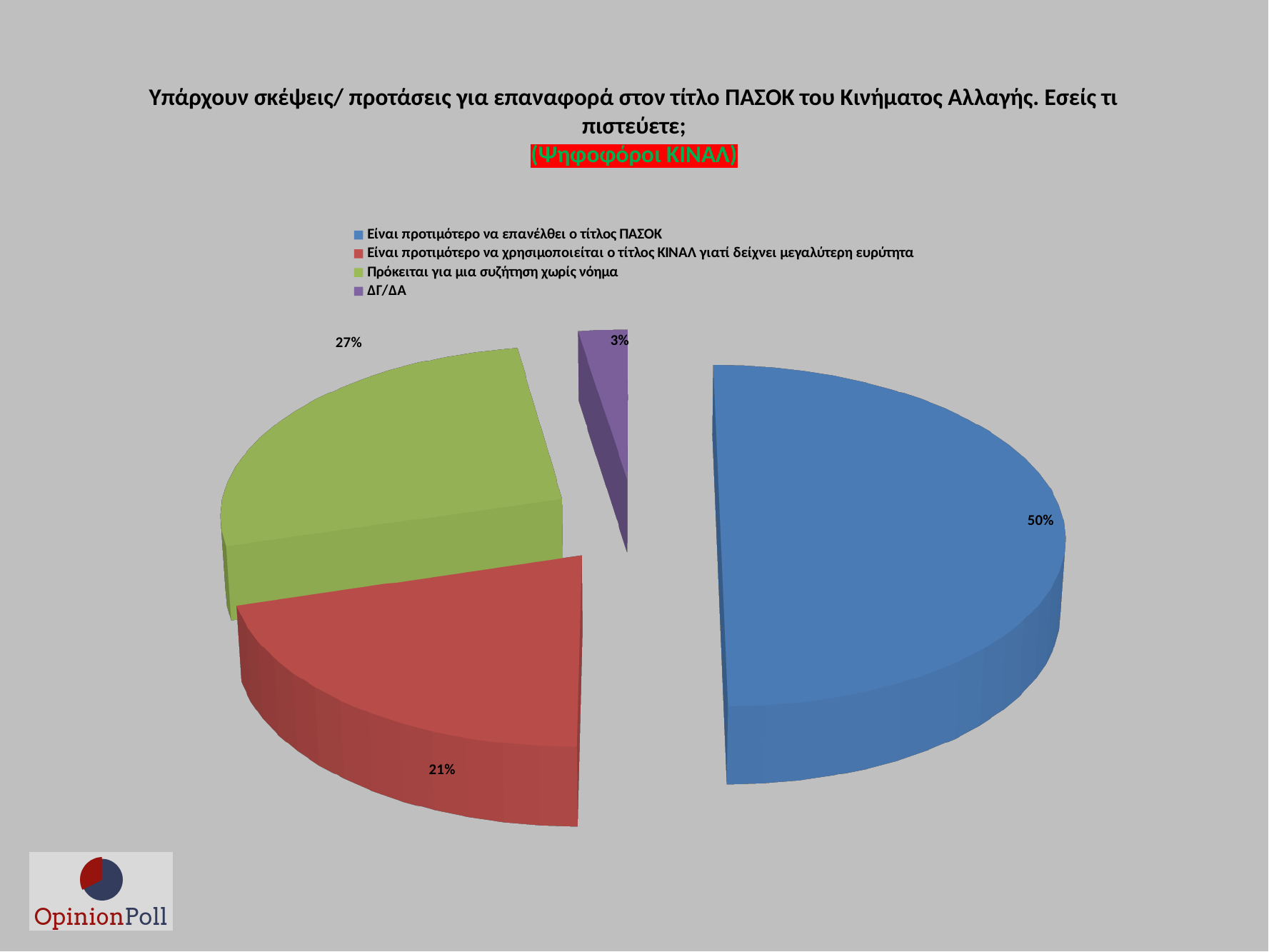
What is the difference in percentage points between the 'Πρόκειται για μια συζήτηση χωρίς νόημα' slice and the 'Είναι προτιμότερο να χρησιμοποιείται ο τίτλος ΚΙΝΑΛ γιατί δείχνει μεγαλύτερη ευρύτητα' slice? 6 percentage points Which category has the largest slice of the pie? Είναι προτιμότερο να επανέλθει ο τίτλος ΠΑΣΟΚ What share of the pie is labelled for 'Είναι προτιμότερο να επανέλθει ο τίτλος ΠΑΣΟΚ'? 50% What share of the pie is labelled for 'Είναι προτιμότερο να χρησιμοποιείται ο τίτλος ΚΙΝΑΛ γιατί δείχνει μεγαλύτερη ευρύτητα'? 21% What colour is the slice for 'ΔΓ/ΔΑ'? Purple What kind of chart is shown on the slide? Pie chart Which is larger: the slice for 'Πρόκειται για μια συζήτηση χωρίς νόημα' or the slice for 'Είναι προτιμότερο να χρησιμοποιείται ο τίτλος ΚΙΝΑΛ γιατί δείχνει μεγαλύτερη ευρύτητα'? Πρόκειται για μια συζήτηση χωρίς νόημα Which group of voters does the chart subtitle say the results refer to? Ψηφοφόροι ΚΙΝΑΛ Which category has the smallest slice of the pie? ΔΓ/ΔΑ How many slices does the pie chart have? 4 What share of the pie is labelled for 'ΔΓ/ΔΑ'? 3% What share of the pie is labelled for 'Πρόκειται για μια συζήτηση χωρίς νόημα'? 27%